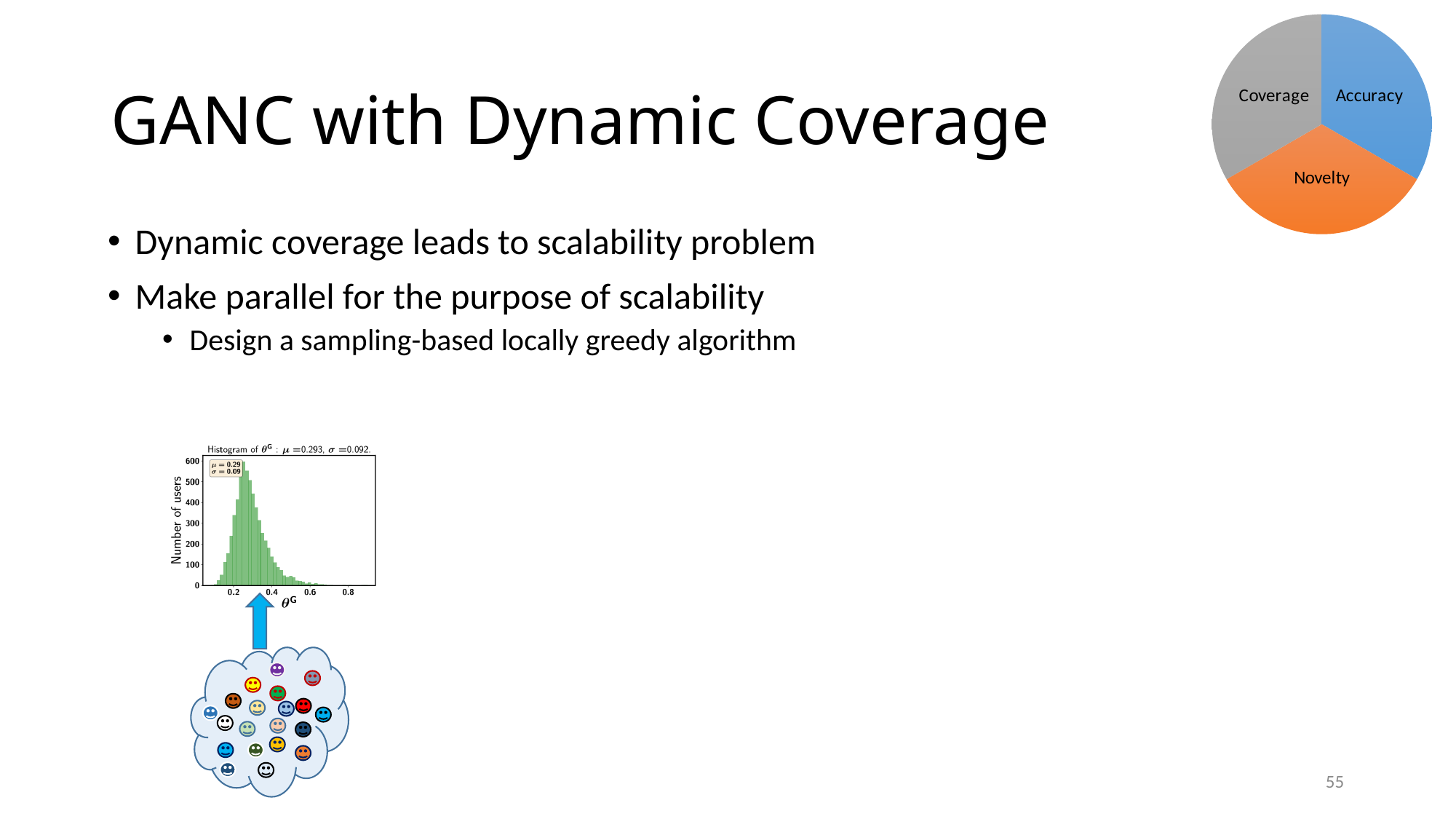
In the pie chart, which slice is coloured orange? Novelty What kind of chart is shown in the top-right corner of the slide? pie chart What is the mean (μ) value stated in the title of the histogram at the bottom-left of the slide? 0.293 In the histogram at the bottom-left, is the tallest bar greater or less than 500 users? greater What is the y-axis label of the histogram at the bottom-left of the slide? Number of users What are the labels of the three slices in the pie chart? Coverage, Accuracy, Novelty In the histogram at the bottom-left, is the bar at θ^G = 0.6 greater or less than 100 users? less What is the standard deviation (σ) value stated in the title of the histogram at the bottom-left of the slide? 0.092 In the histogram at the bottom-left, do the bar heights rise or fall as θ^G increases from 0.4 to 0.8? fall How many slices does the pie chart in the top-right corner have? 3